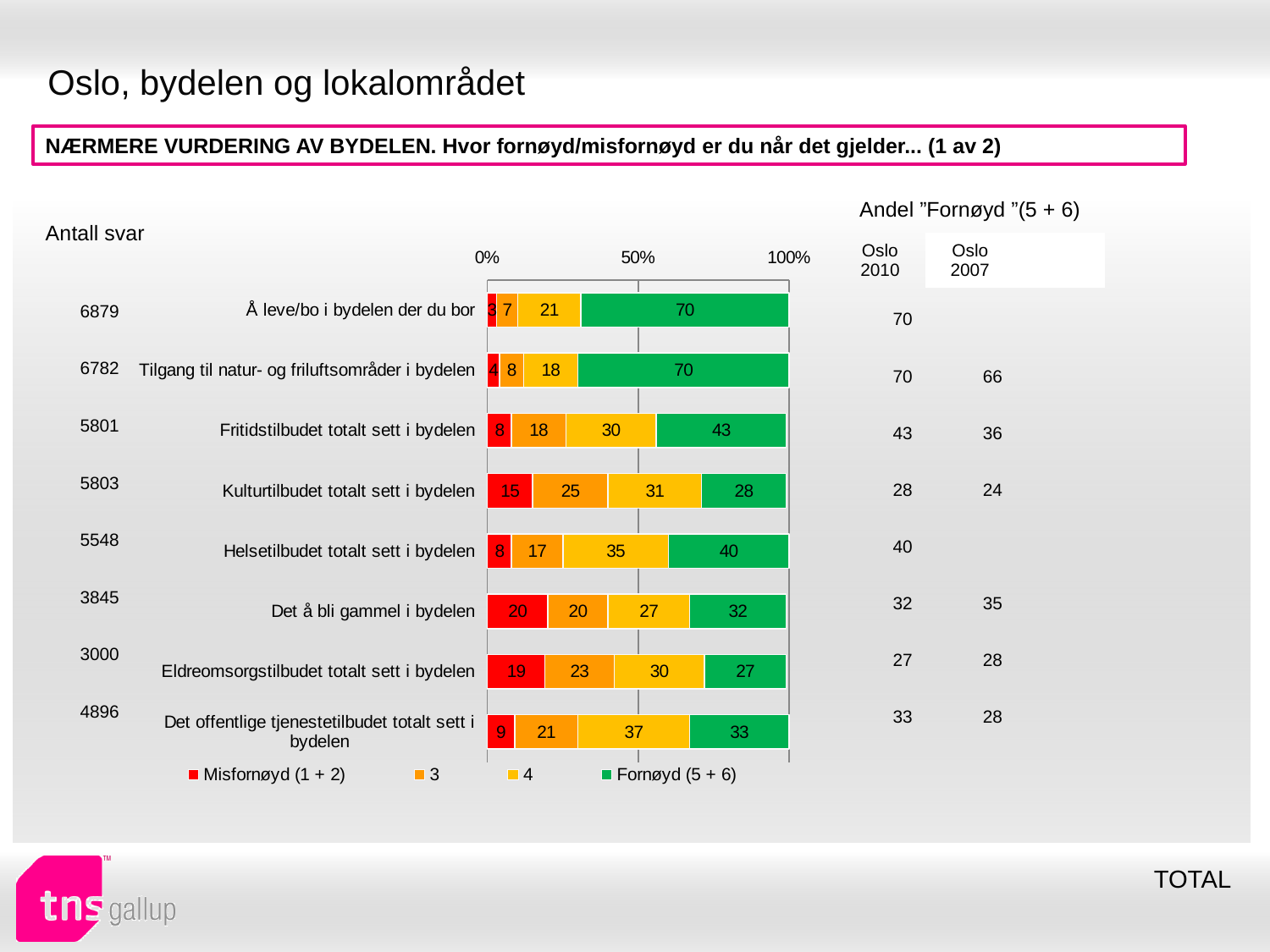
Which category has the lowest value in the "4" series? Tilgang til natur- og friluftsområder i bydelen What is the value of the Misfornøyd (1 + 2) segment for "Kulturtilbudet totalt sett i bydelen"? 15 Is the Fornøyd (5 + 6) value for "Å leve/bo i bydelen der du bor" greater or less than 50%? greater Which has a larger Fornøyd (5 + 6) value: "Helsetilbudet totalt sett i bydelen" or "Det å bli gammel i bydelen"? Helsetilbudet totalt sett i bydelen What is the value of the "4" segment for "Det offentlige tjenestetilbudet totalt sett i bydelen"? 37 What is the difference between the Fornøyd (5 + 6) values for "Fritidstilbudet totalt sett i bydelen" and "Kulturtilbudet totalt sett i bydelen"? 15 What kind of chart is shown on the slide? Stacked bar chart What is the value of the Fornøyd (5 + 6) segment for "Fritidstilbudet totalt sett i bydelen"? 43 How many series does the legend list? 4 How many categories are shown in the bar chart? 8 Which category has the highest value in the "4" series? Det offentlige tjenestetilbudet totalt sett i bydelen What is the total of the stacked bar for "Helsetilbudet totalt sett i bydelen"? 100